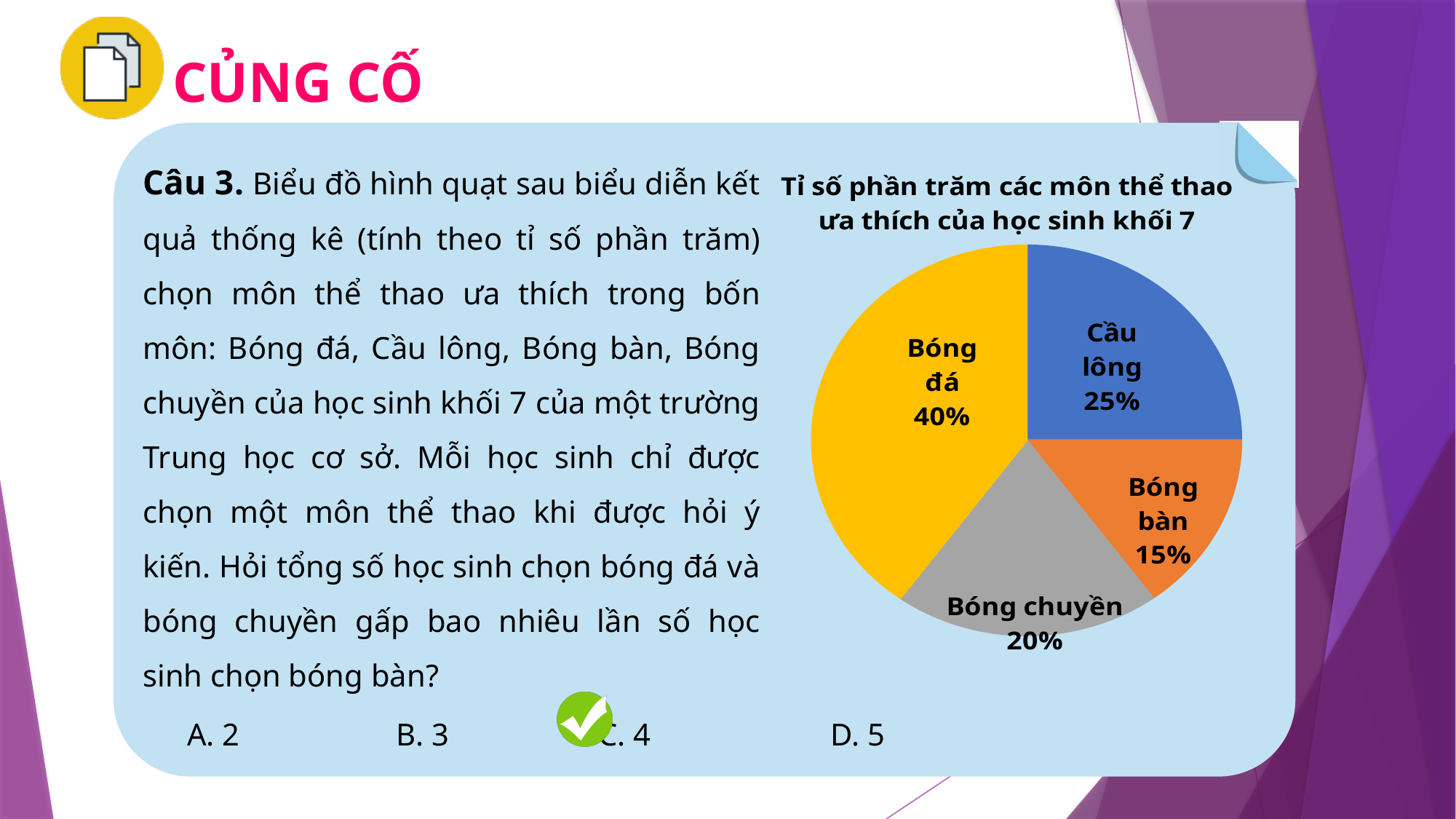
Which sport has the largest slice in the pie chart? Bóng đá What is the difference in percentage points between Bóng đá and Cầu lông? 15% What colour is the Bóng đá slice in the pie chart? yellow What percentage of the pie chart is Bóng bàn? 15% What percentage of the pie chart is Bóng đá? 40% What percentage of the pie chart is Bóng chuyền? 20% What is the title of the pie chart? Tỉ số phần trăm các môn thể thao ưa thích của học sinh khối 7 How many slices does the pie chart have? 4 What type of chart is shown on the slide? pie chart What percentage of the pie chart is Cầu lông? 25% Which is larger, the slice for Bóng chuyền or the slice for Bóng bàn? Bóng chuyền Which sport has the smallest slice in the pie chart? Bóng bàn